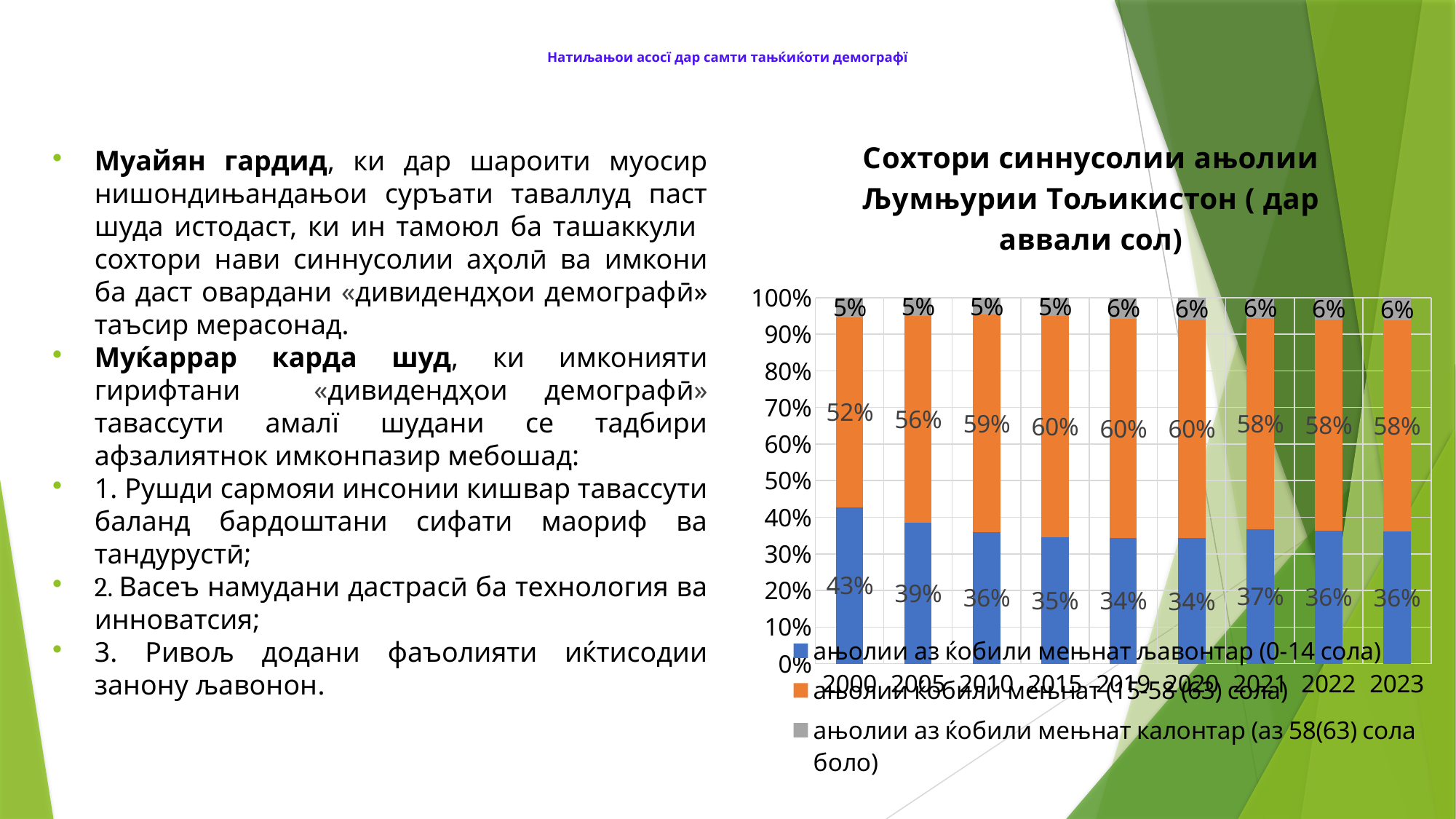
What is the value of the orange (15-58(63) сола) series for 2015? 60% What is the difference between the blue series value in 2000 and in 2023? 7% What is the value of the grey (аз 58(63) сола боло) series for 2023? 6% In which year is the blue (0-14 сола) series highest? 2000 What is the value of the blue (0-14 сола) series for 2000? 43% Does the blue (0-14 сола) series generally rise or fall from 2000 to 2020? fall What is the title of the chart? Сохтори синнусолии ањолии Љумњурии Тољикистон ( дар аввали сол) Which is larger in 2005: the blue series value or the orange series value? orange (56%) How many series does the chart legend list? 3 In which year is the orange (15-58(63) сола) series lowest? 2000 What kind of chart is shown on the slide? stacked bar chart How many years are shown on the x axis of the chart? 9